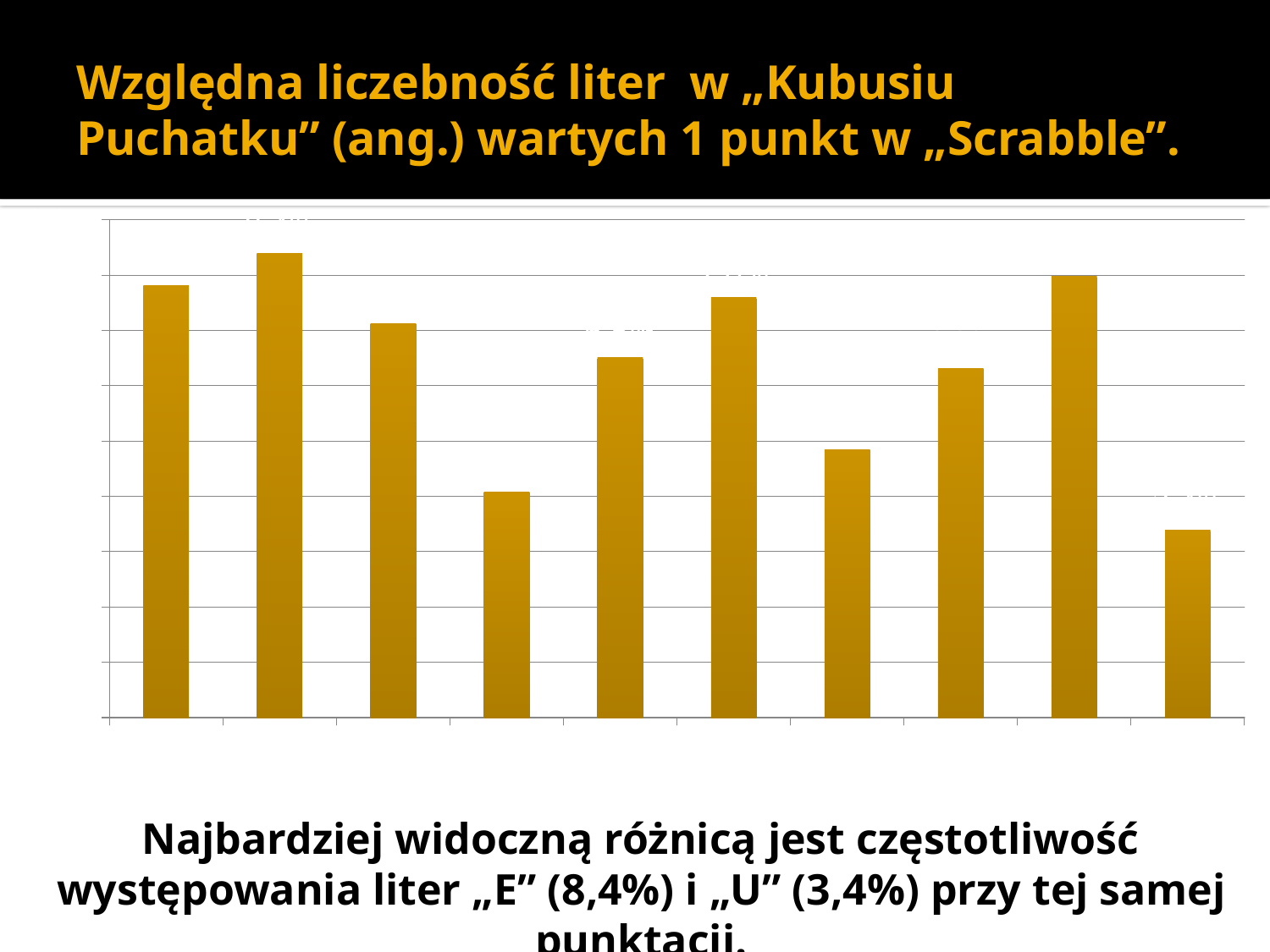
What kind of chart is shown on the slide? bar chart Which is shorter: the seventh bar from the left or the sixth bar from the left? the seventh bar What colour are the bars in the chart? gold (orange-yellow) What is the title of the slide containing the chart? Względna liczebność liter w „Kubusiu Puchatku” (ang.) wartych 1 punkt w „Scrabble”. Which is taller: the fourth bar from the left or the fifth bar from the left? the fifth bar Which bar is the shortest in the chart, counting from the left? the last (tenth) bar How many bars does the chart contain? 10 Which is taller: the first bar from the left or the third bar from the left? the first bar Which bar is the tallest in the chart, counting from the left? the second bar